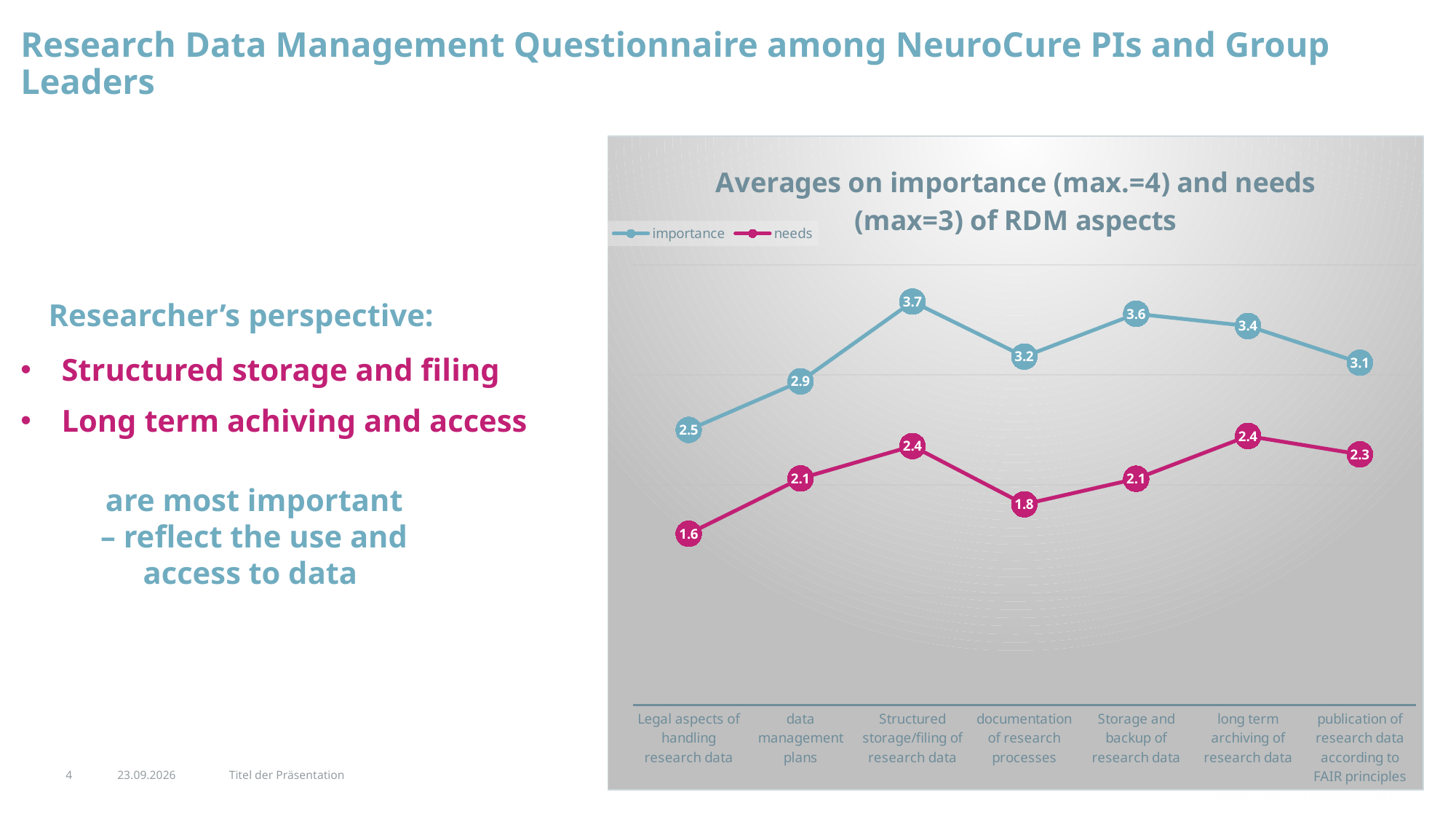
What kind of chart is shown on the slide? line chart Which category has the highest importance value? Structured storage/filing of research data What is the needs value for Legal aspects of handling research data? 1.6 Which category has the lowest needs value? Legal aspects of handling research data How many categories are shown on the x axis? 7 What is the needs value for documentation of research processes? 1.8 What is the importance value for publication of research data according to FAIR principles? 3.1 What is the difference between the importance and needs values for Storage and backup of research data? 1.5 How many series does the legend list? 2 Which is larger: the needs value for long term archiving of research data or the needs value for data management plans? long term archiving of research data What is the title of the chart? Averages on importance (max.=4) and needs (max=3) of RDM aspects What is the importance value for Structured storage/filing of research data? 3.7